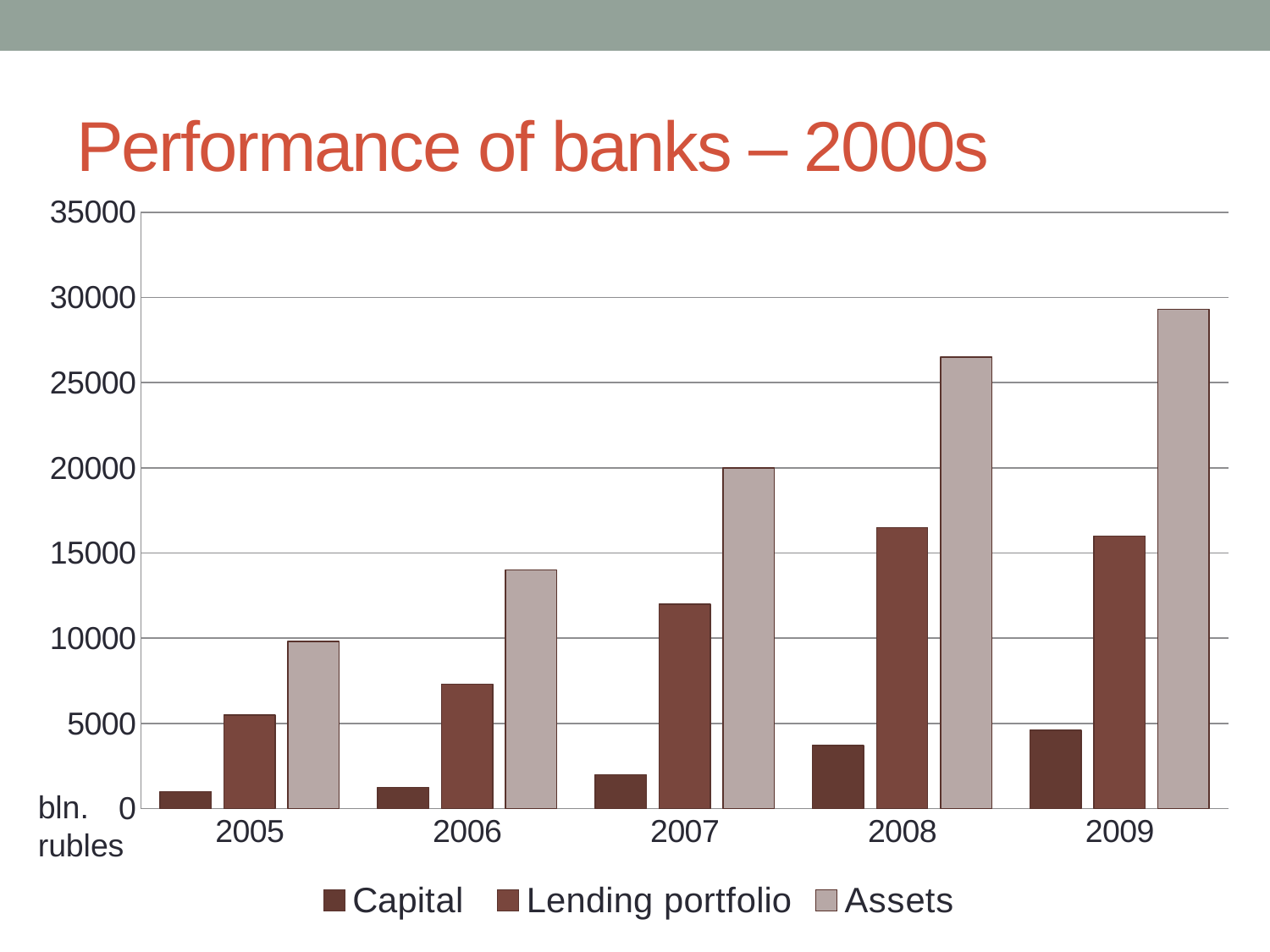
What unit is given for the y axis? bln. rubles What kind of chart is shown on the slide? bar chart Which year has the lowest Capital bar? 2005 How many years are shown on the x axis? 5 Which is larger: Assets in 2007 or Lending portfolio in 2008? Assets in 2007 How many series does the legend list? 3 Is the Assets value for 2006 greater or less than 15000? less Is the Lending portfolio value for 2006 greater or less than 5000? greater Is the Assets value for 2009 greater or less than 25000? greater Which series has the tallest bar in 2009? Assets Do the Assets values rise or fall from 2005 to 2009? rise